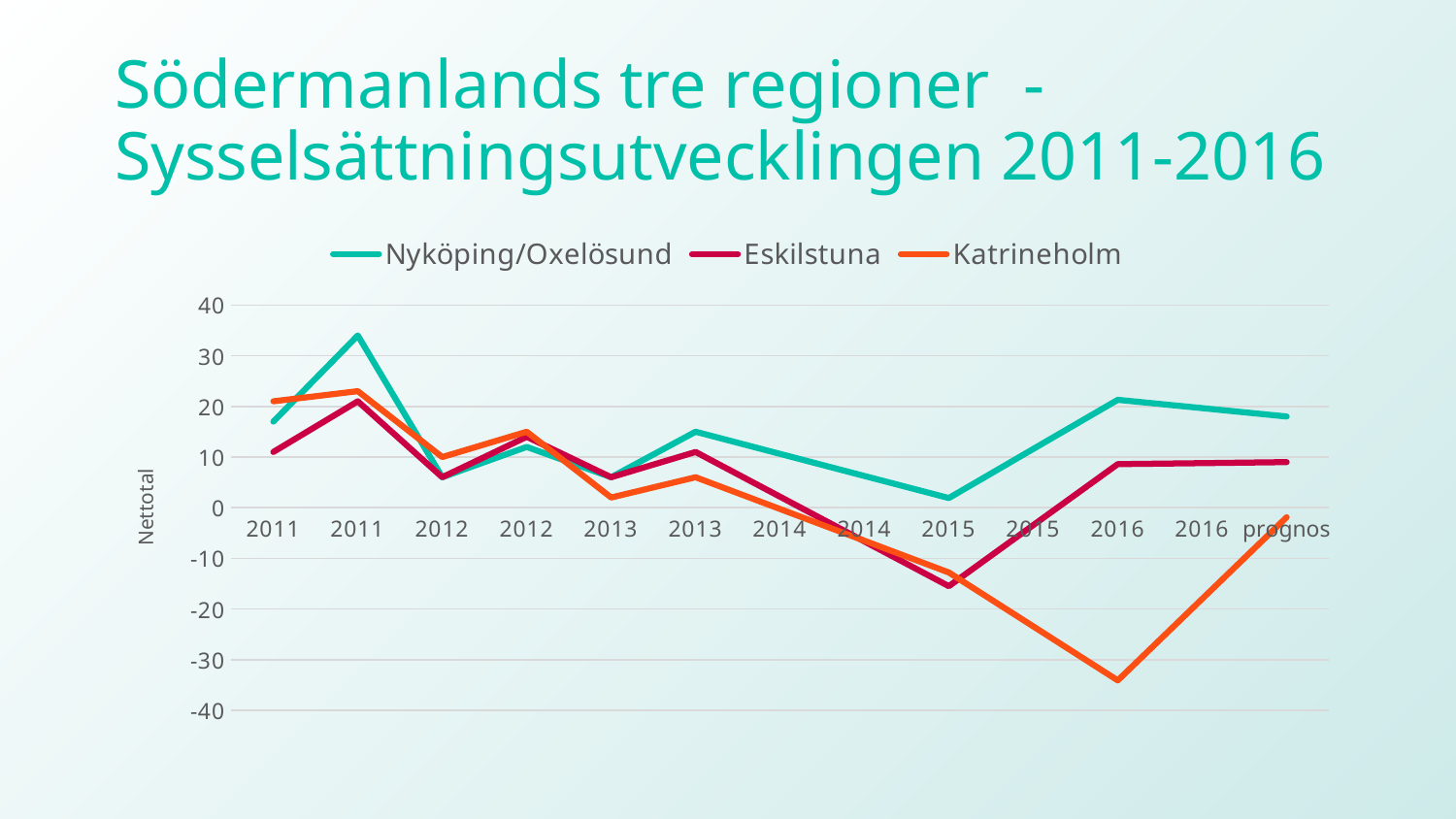
Does the Katrineholm line rise or fall between 2013 and 2016? fall Is the highest value for Nyköping/Oxelösund greater or less than 30? greater Which series are listed in the legend? Nyköping/Oxelösund, Eskilstuna, Katrineholm How many points are labelled along the x axis? 13 What kind of chart is shown on the slide? line chart Is the lowest value for Eskilstuna greater or less than -10? less How many series does the legend list? 3 Which series reaches the lowest value anywhere on the chart? Katrineholm Is the lowest value for Katrineholm greater or less than -30? less At 2016 prognos, which is larger: Nyköping/Oxelösund or Katrineholm? Nyköping/Oxelösund Which series reaches the highest value anywhere on the chart? Nyköping/Oxelösund What is the label on the vertical axis? Nettotal